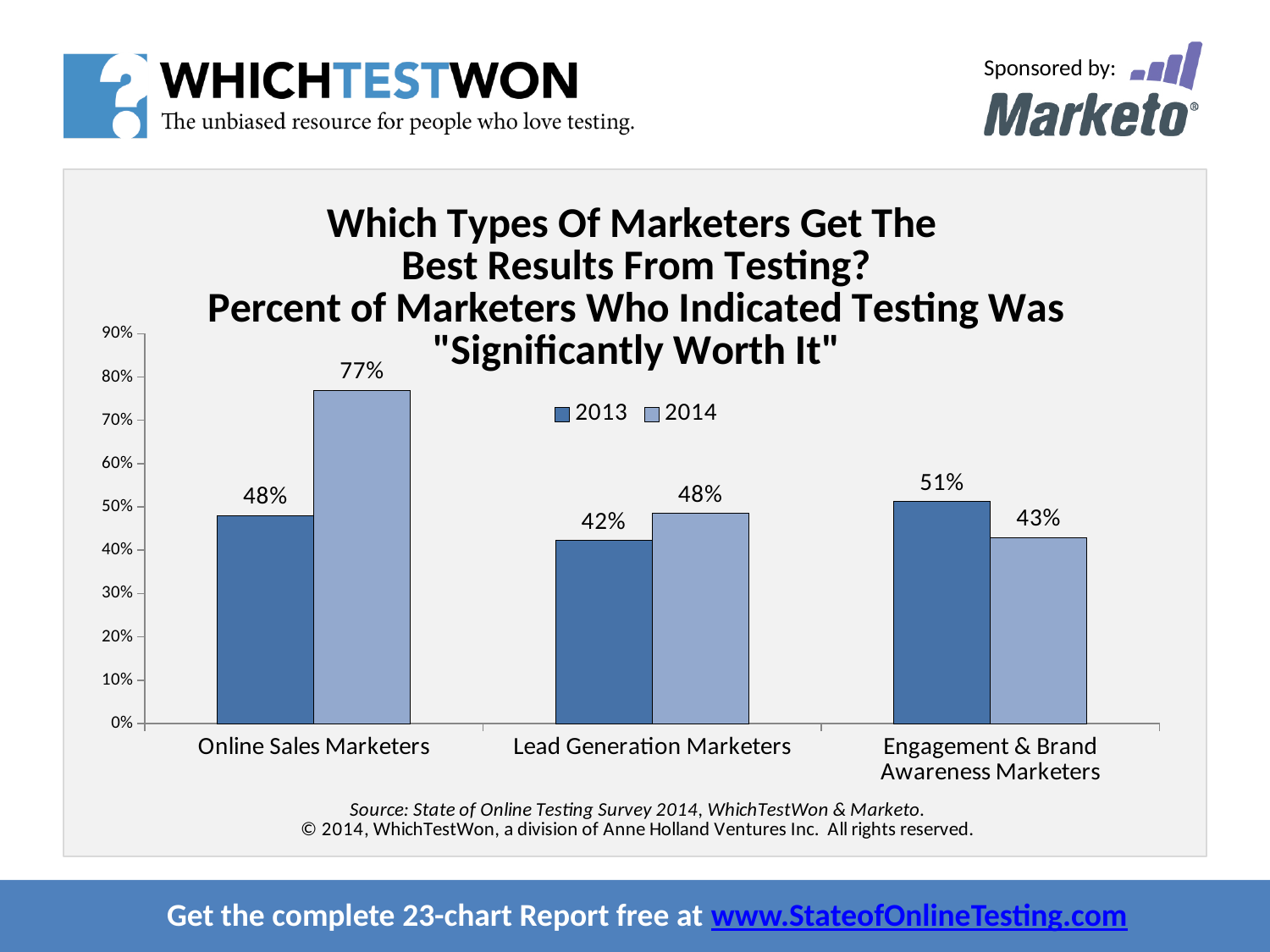
For Engagement & Brand Awareness Marketers, which year has the larger value, 2013 or 2014? 2013 Which category has the highest 2014 value? Online Sales Marketers Which category has the lowest 2013 value? Lead Generation Marketers What kind of chart is shown on the slide? bar chart What is the 2013 value for Engagement & Brand Awareness Marketers? 51% What is the difference between the 2014 and 2013 values for Online Sales Marketers? 29% What is the 2014 value for Engagement & Brand Awareness Marketers? 43% How many series does the legend list? 2 What is the 2013 value for Lead Generation Marketers? 42% What is the 2014 value for Online Sales Marketers? 77% How many marketer categories are shown on the x axis? 3 Is the 2014 value for Online Sales Marketers greater or less than 70%? greater